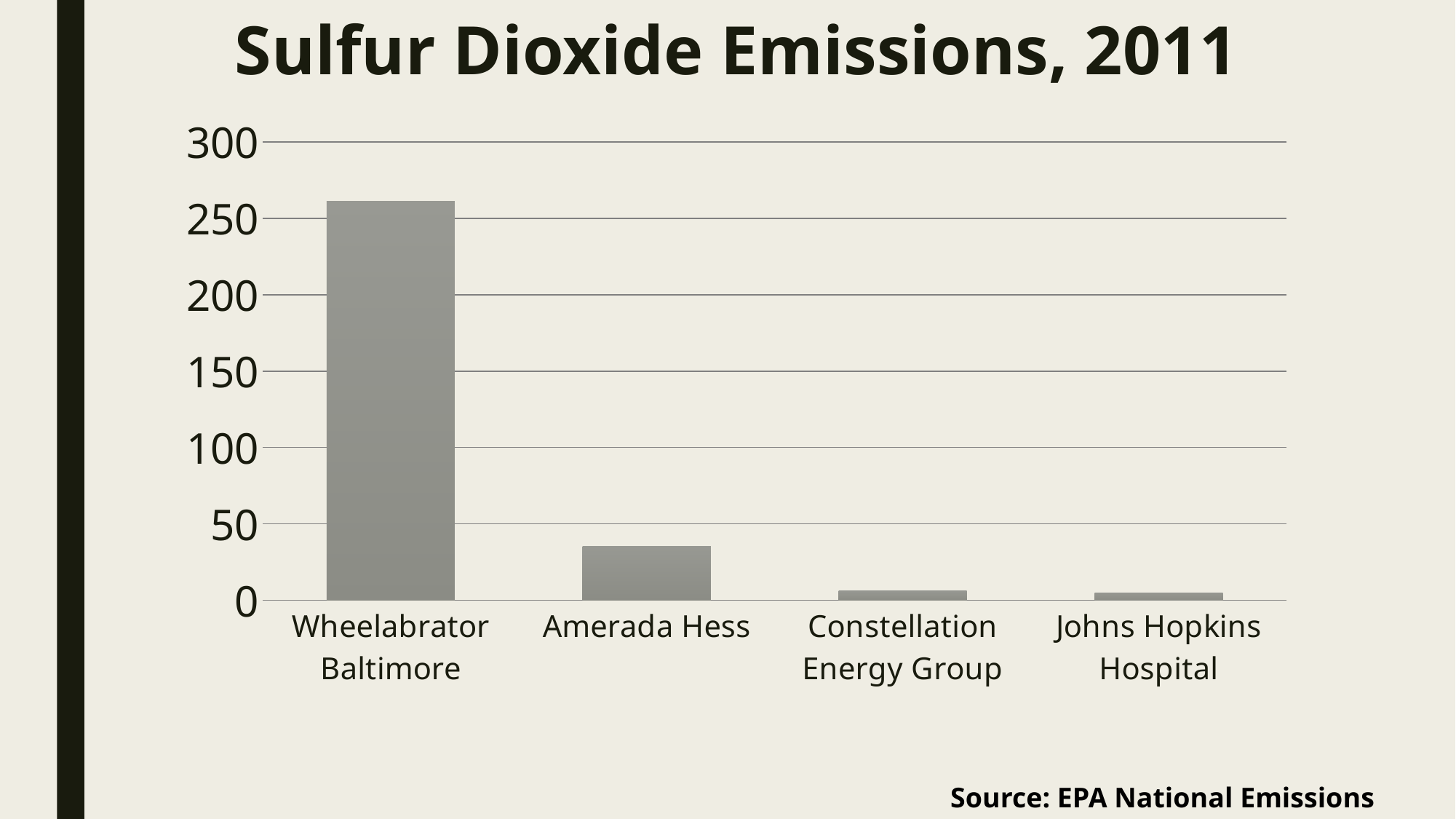
Which is larger, the value for Amerada Hess or the value for Johns Hopkins Hospital? Amerada Hess Is the value for Amerada Hess greater or less than 50? less Is the value for Constellation Energy Group greater or less than 50? less Do the values generally rise or fall moving from left to right along the x axis? fall What is the title of the chart? Sulfur Dioxide Emissions, 2011 Which is larger, the value for Wheelabrator Baltimore or the value for Amerada Hess? Wheelabrator Baltimore Which category has the highest sulfur dioxide emissions? Wheelabrator Baltimore What kind of chart is shown on the slide? bar chart How many categories are shown on the x axis of the chart? 4 Is the value for Wheelabrator Baltimore greater or less than 200? greater What source is cited for the chart data? EPA National Emissions